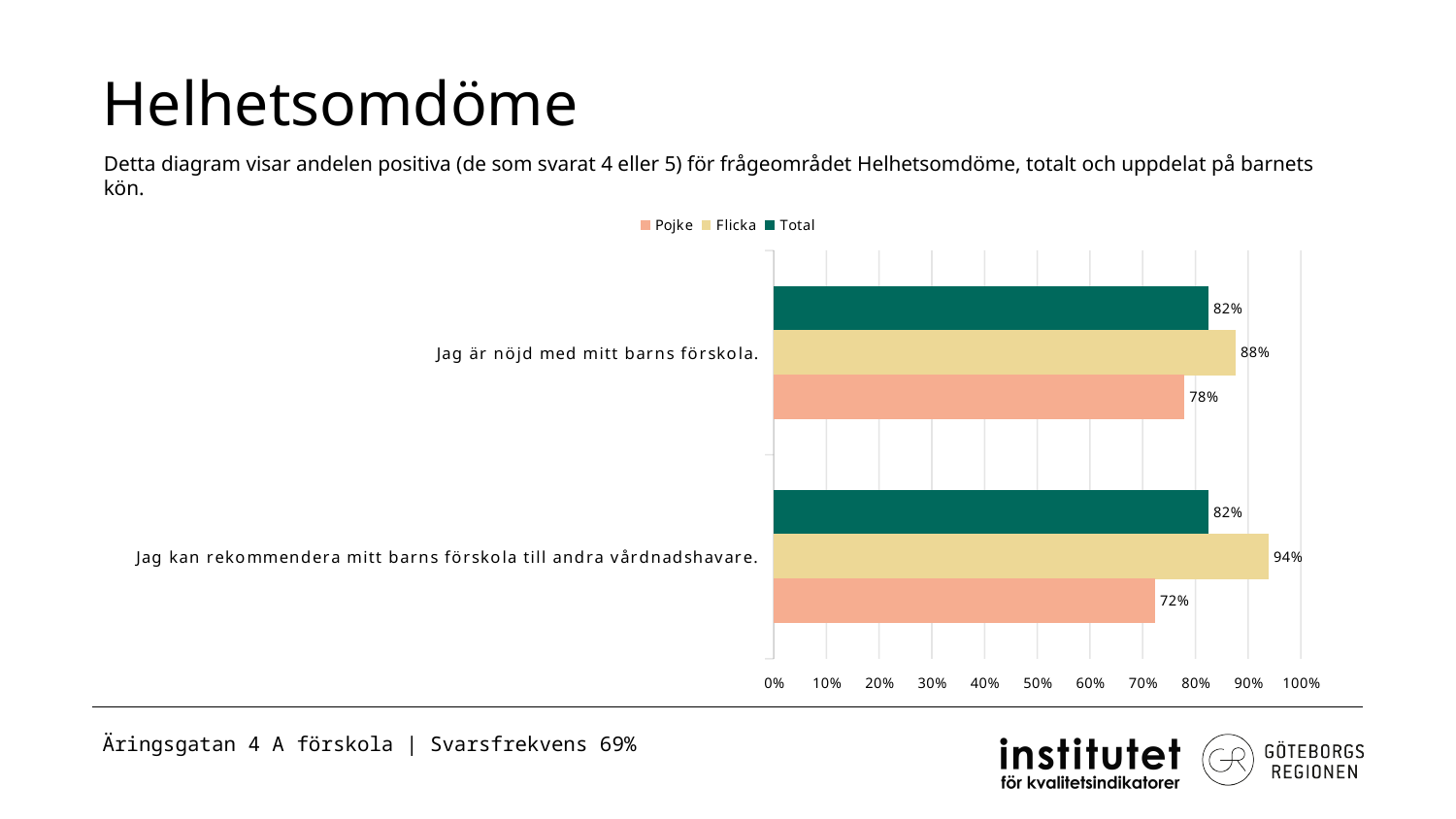
Which is larger: the Flicka value for "Jag är nöjd med mitt barns förskola." or the Flicka value for "Jag kan rekommendera mitt barns förskola till andra vårdnadshavare."? Jag kan rekommendera mitt barns förskola till andra vårdnadshavare. Which series has the highest value for "Jag kan rekommendera mitt barns förskola till andra vårdnadshavare."? Flicka What is the difference between the Flicka and Pojke values for "Jag kan rekommendera mitt barns förskola till andra vårdnadshavare."? 22% What is the Pojke value for "Jag är nöjd med mitt barns förskola."? 78% What is the Total value for "Jag är nöjd med mitt barns förskola."? 82% Which series has the lowest value for "Jag är nöjd med mitt barns förskola."? Pojke How many categories are shown on the chart? 2 How many series does the legend list? 3 What is the difference between the Flicka and Pojke values for "Jag är nöjd med mitt barns förskola."? 10% What is the Flicka value for "Jag kan rekommendera mitt barns förskola till andra vårdnadshavare."? 94% What is the Pojke value for "Jag kan rekommendera mitt barns förskola till andra vårdnadshavare."? 72% What kind of chart is shown on the slide? Bar chart